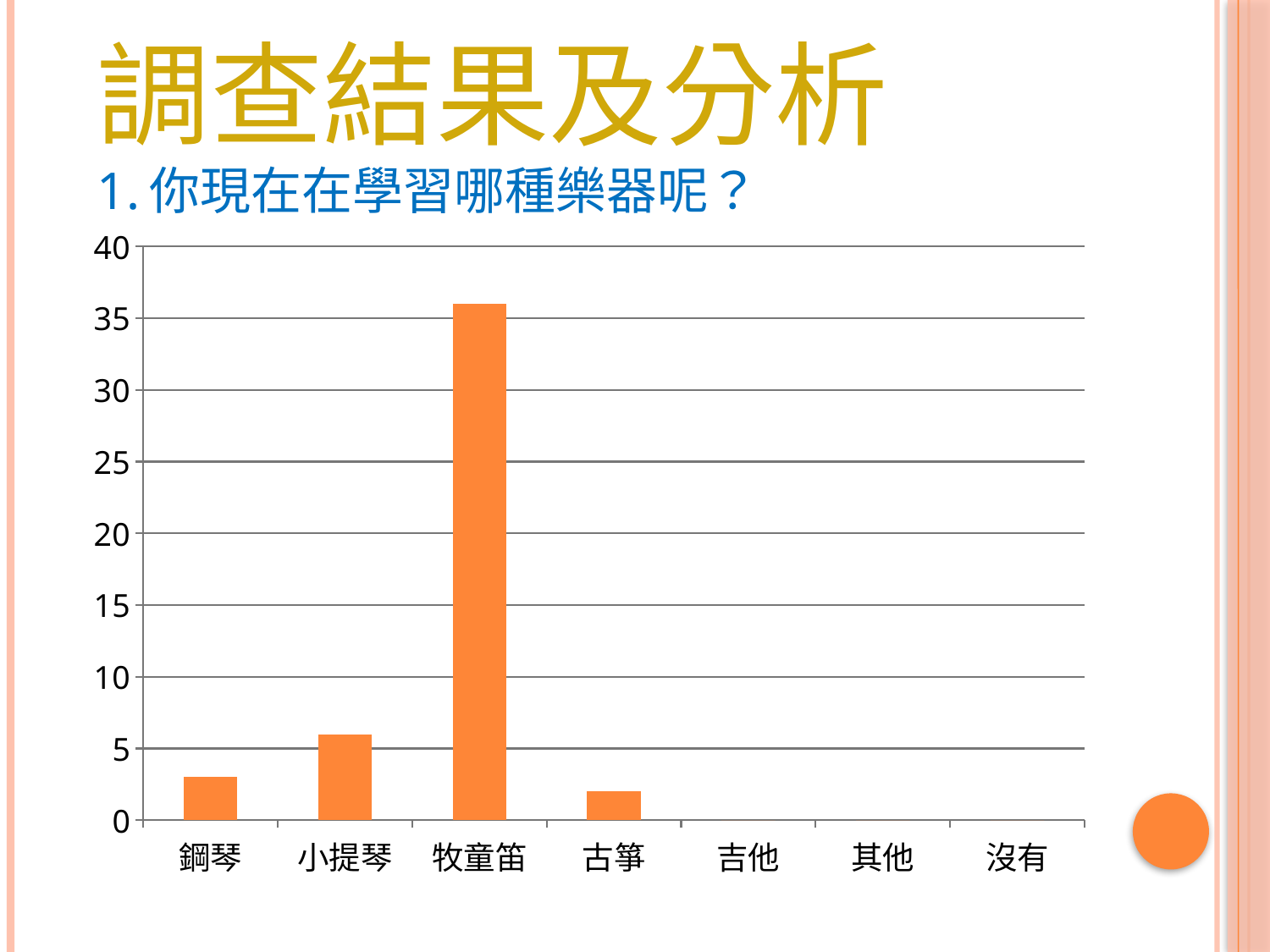
Is the value for 古箏 greater or less than 5? less What kind of chart is shown on the slide? bar chart Which category has the highest value in the chart? 牧童笛 Is the value for 牧童笛 greater or less than 30? greater Is the value for 鋼琴 greater or less than 5? less What question is the chart on the slide about? 1. 你現在在學習哪種樂器呢？ Which has a larger value, 牧童笛 or 古箏? 牧童笛 How many categories are shown on the x axis of the chart? 7 What is the highest value shown on the y axis of the chart? 40 Which has a larger value, 小提琴 or 鋼琴? 小提琴 What is the value for 吉他 in the chart? 0